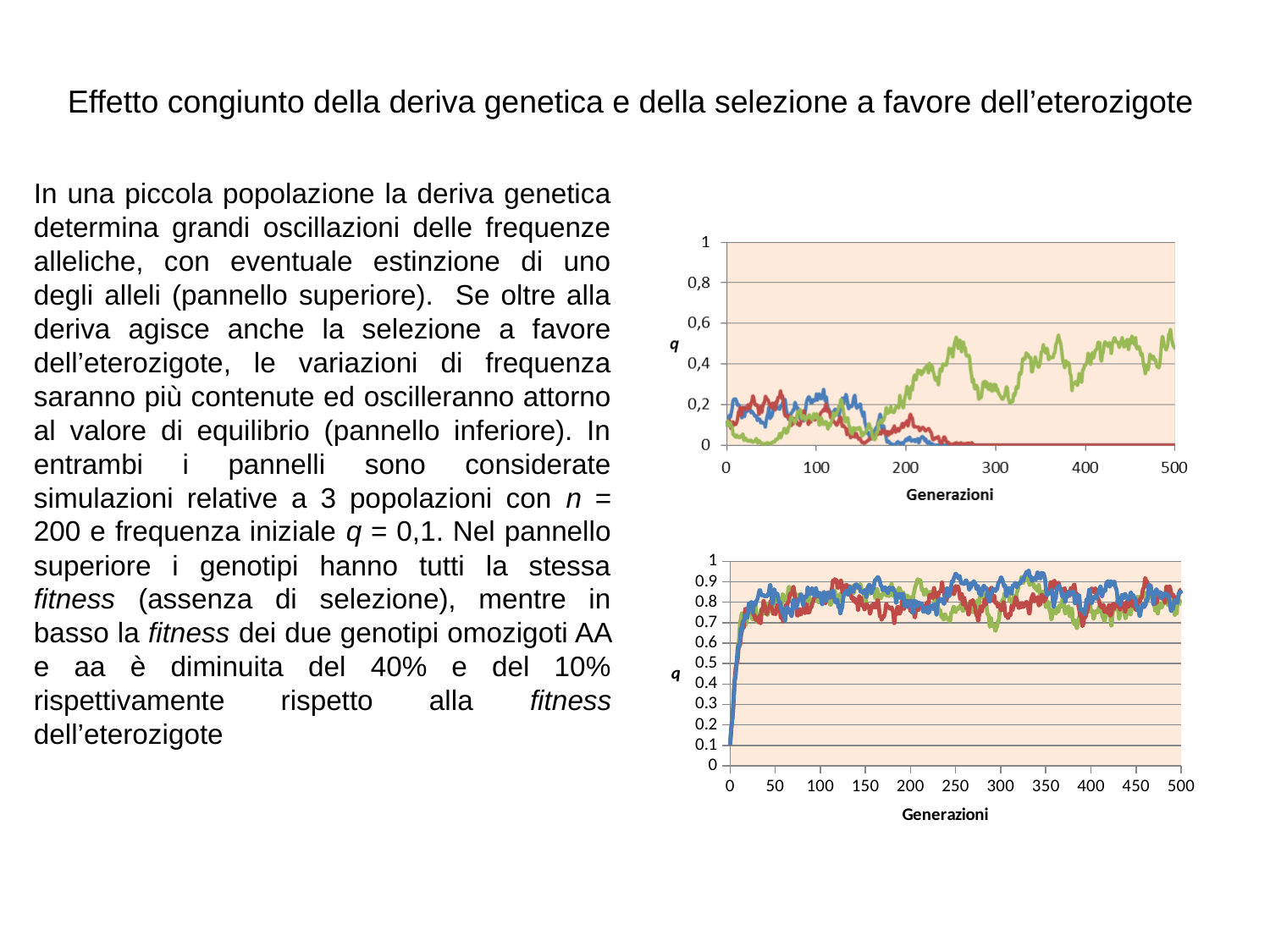
In the upper chart, which line has the highest value at generation 500? the green line In the upper chart, does the green line overall rise or fall between generation 0 and generation 500? rise What kind of chart is the lower chart on the slide? line chart In the lower chart, what is the label of the y axis? q In the lower chart, is the value of the lines at generation 0 greater or less than 0.5? less In the upper chart, how many lines (populations) are plotted? 3 In the upper chart, is the value of the green line at generation 500 greater or less than 0.4? greater In the lower chart, how many lines (populations) are plotted? 3 In the upper chart, what is the label of the x axis? Generazioni What kind of chart is the upper chart on the slide? line chart In the upper chart, is the value of the red line at generation 400 greater or less than 0.2? less